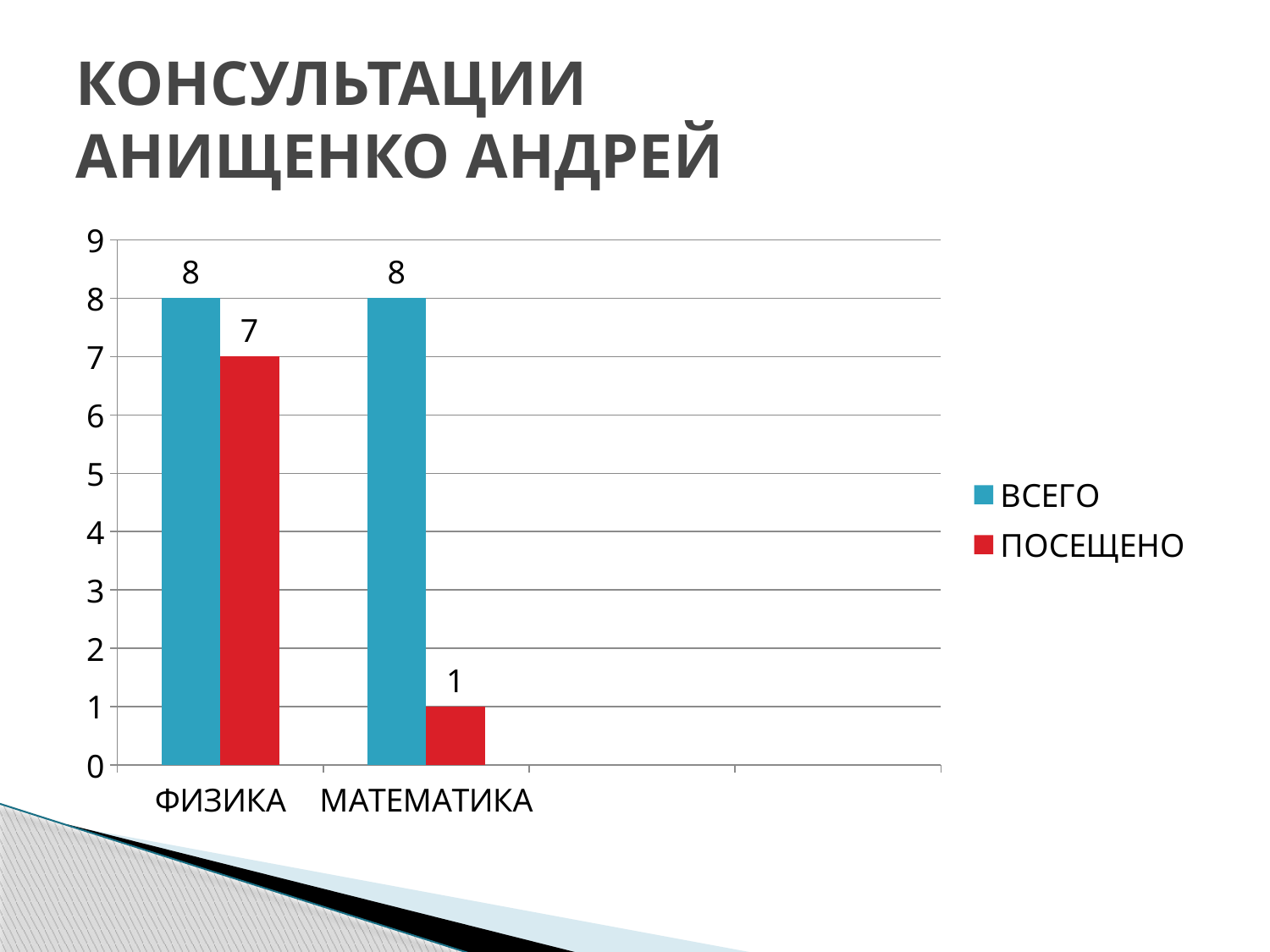
What is the ВСЕГО value for МАТЕМАТИКА? 8 Which category has the highest ПОСЕЩЕНО value? ФИЗИКА What kind of chart is shown on the slide? bar chart What is the difference between the ПОСЕЩЕНО values for ФИЗИКА and МАТЕМАТИКА? 6 What is the ПОСЕЩЕНО value for МАТЕМАТИКА? 1 How many series does the legend list? 2 What is the ПОСЕЩЕНО value for ФИЗИКА? 7 Which is larger: the ПОСЕЩЕНО value for ФИЗИКА or for МАТЕМАТИКА? ФИЗИКА Which category has the lowest ПОСЕЩЕНО value? МАТЕМАТИКА How many categories are shown on the x axis? 2 What is the ВСЕГО value for ФИЗИКА? 8 What is the difference between the ВСЕГО and ПОСЕЩЕНО values for МАТЕМАТИКА? 7